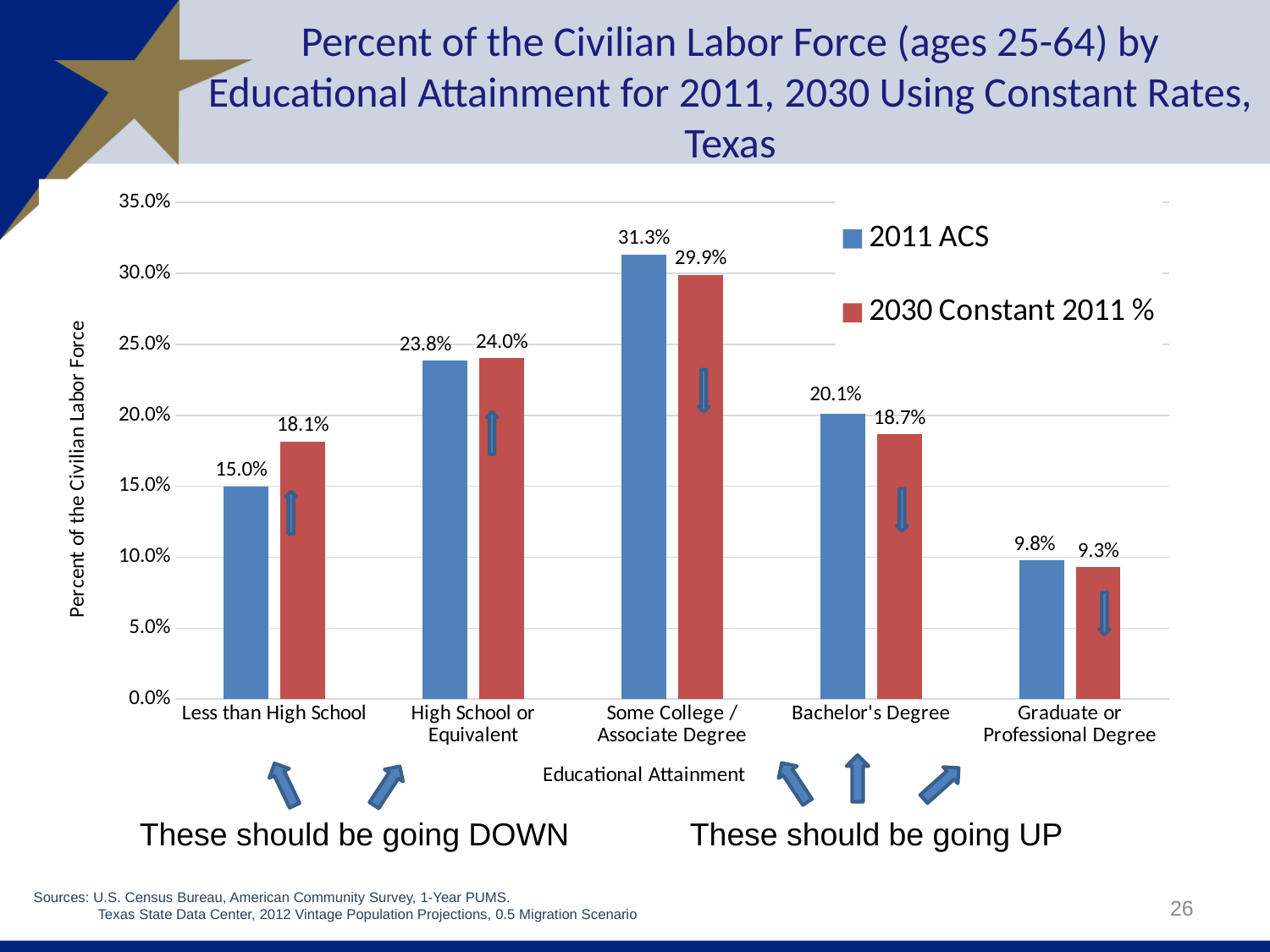
What is the label of the y axis? Percent of the Civilian Labor Force Which educational attainment category has the lowest 2030 Constant 2011 % value? Graduate or Professional Degree How many series does the legend list? 2 Which educational attainment category has the highest 2011 ACS value? Some College / Associate Degree What is the 2030 Constant 2011 % value for Less than High School? 18.1% What is the difference between the 2011 ACS and 2030 Constant 2011 % values for Bachelor's Degree? 1.4% For High School or Equivalent, which is larger: the 2011 ACS value or the 2030 Constant 2011 % value? 2030 Constant 2011 % How many educational attainment categories are shown on the x axis? 5 What is the 2011 ACS value for Some College / Associate Degree? 31.3% What is the difference between the 2011 ACS and 2030 Constant 2011 % values for Less than High School? 3.1% What kind of chart is shown on the slide? Bar chart What is the 2011 ACS value for Graduate or Professional Degree? 9.8%